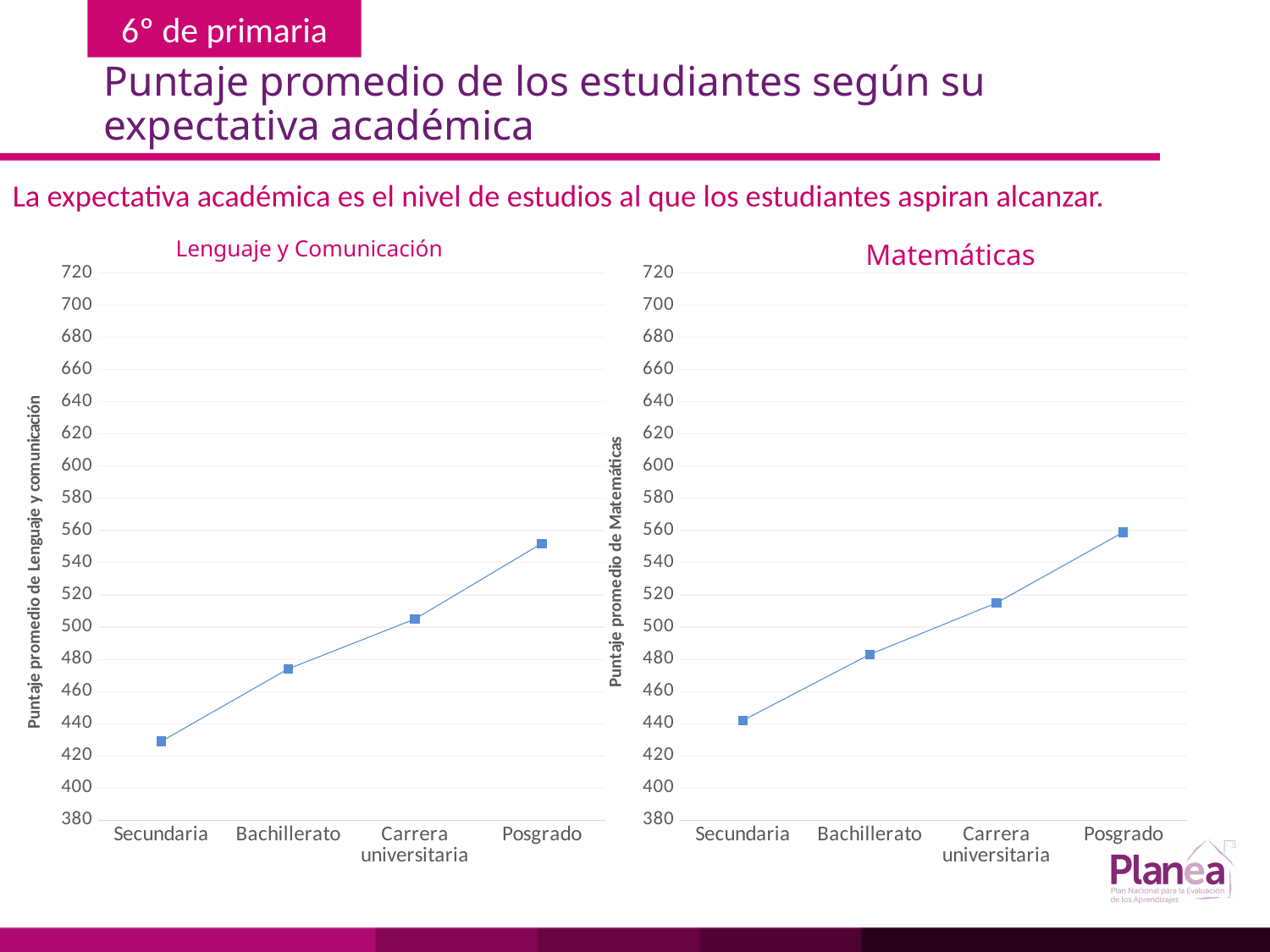
In the 'Lenguaje y Comunicación' chart, is the value for Posgrado greater or less than 540? greater What is the y-axis label of the 'Matemáticas' chart? Puntaje promedio de Matemáticas In the 'Lenguaje y Comunicación' chart, is the value for Secundaria greater or less than 440? less In the 'Matemáticas' chart, is the value for Carrera universitaria greater or less than 500? greater What kind of chart is the 'Lenguaje y Comunicación' chart? line chart How many categories are shown on the x axis of the 'Matemáticas' chart? 4 In the 'Matemáticas' chart, which is larger, the value for Bachillerato or the value for Posgrado? Posgrado In the 'Matemáticas' chart, which category has the lowest average score? Secundaria What is the title of the chart on the right side of the slide? Matemáticas In the 'Lenguaje y Comunicación' chart, do the values rise or fall from Secundaria to Posgrado? rise In the 'Lenguaje y Comunicación' chart, which category has the highest average score? Posgrado